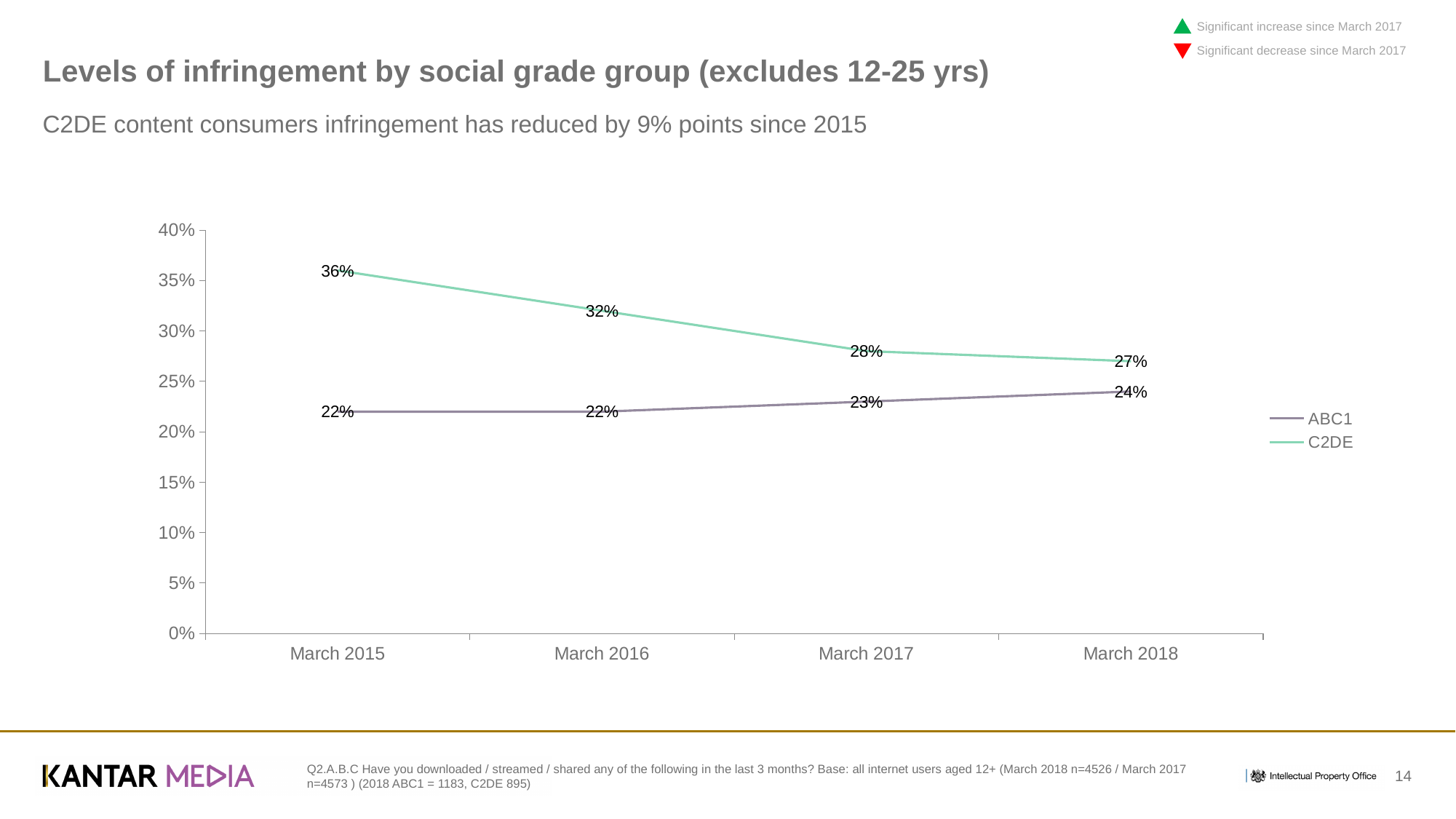
What is the ABC1 value for March 2018? 24% What is the difference between the C2DE and ABC1 values in March 2015? 14% What is the ABC1 value for March 2016? 22% What is the difference between the C2DE values for March 2015 and March 2018? 9% Which series has the larger value in March 2018, ABC1 or C2DE? C2DE What is the C2DE value for March 2017? 28% In which period is the C2DE value highest? March 2015 How many series does the legend list? 2 What is the C2DE value for March 2015? 36% What kind of chart is shown on the slide? Line chart In which period is the C2DE value lowest? March 2018 How many time periods are shown on the x axis? 4